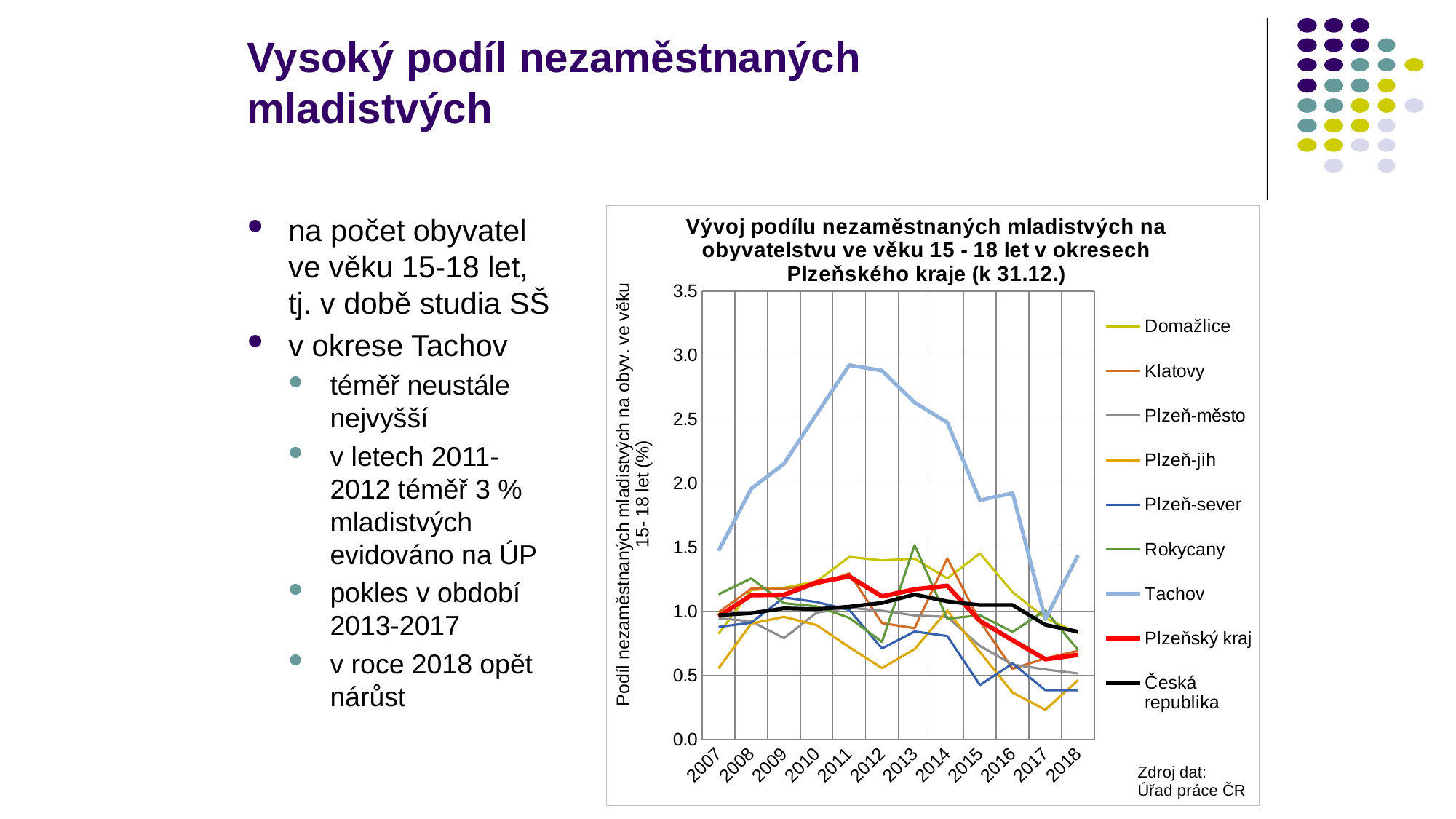
Which series has the lowest value in 2017? Plzeň-jih What kind of chart is shown on the slide? line chart Is the value for Plzeň-jih in 2017 greater or less than 0.5? less How many series does the chart legend list? 9 Is the value for Tachov in 2015 greater or less than 1.5? greater In 2012, which is larger: the value for Tachov or the value for Česká republika? Tachov How many years are shown on the x axis of the chart? 12 Which series has the highest value in 2011? Tachov Is the value for Tachov in 2011 greater or less than 2.5? greater Which series is drawn with a thick black line? Česká republika Does the Tachov line rise or fall between 2013 and 2017? fall